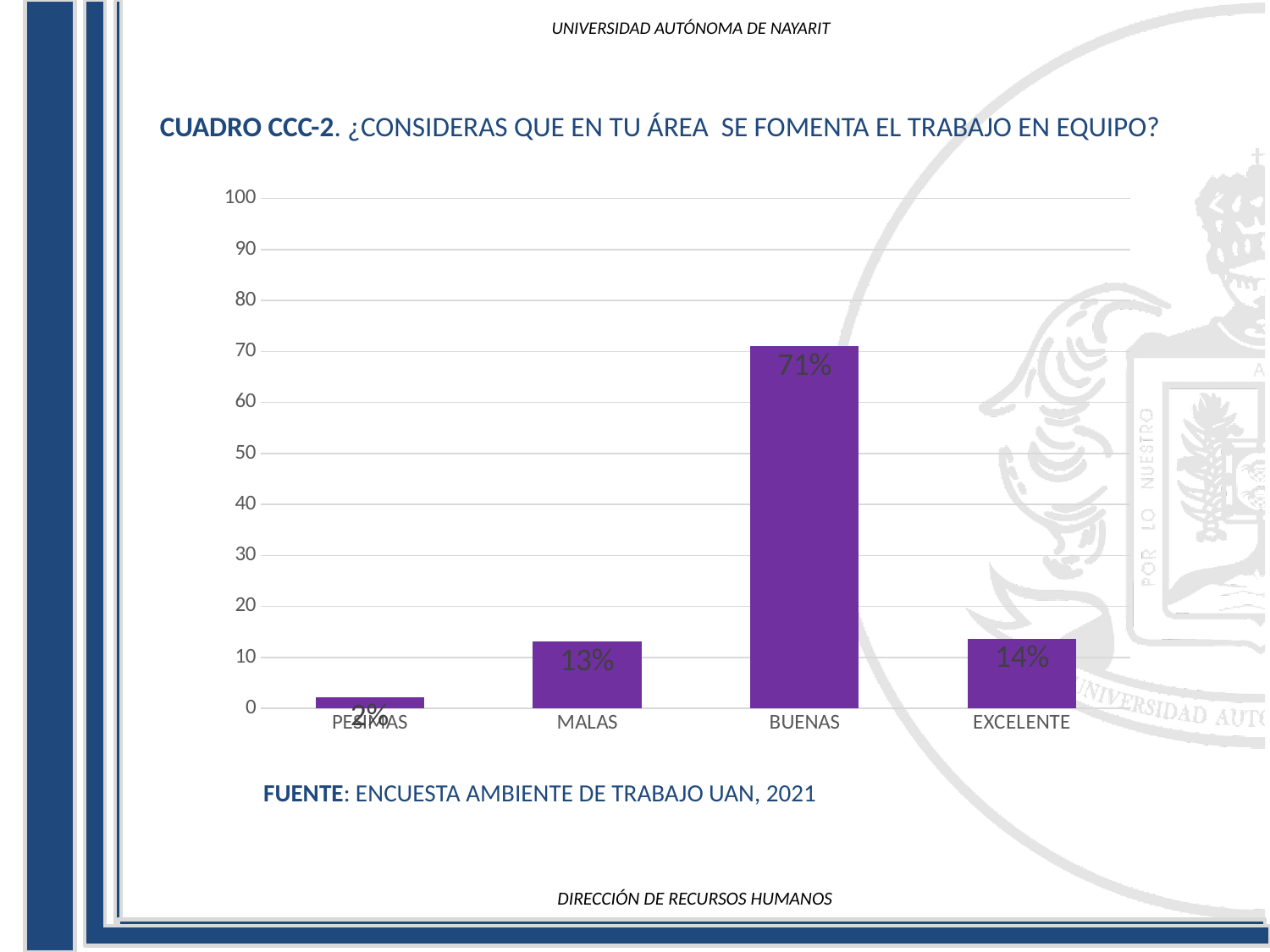
Which is larger, the value for MALAS or the value for EXCELENTE? EXCELENTE How many categories are shown on the x axis? 4 What is the value for EXCELENTE? 14% What is the value for BUENAS? 71% Which category has the highest value? BUENAS What is the difference between the values for BUENAS and EXCELENTE? 57% What source is cited below the chart? ENCUESTA AMBIENTE DE TRABAJO UAN, 2021 Is the value for BUENAS greater or less than 50? greater What kind of chart is shown on the slide? bar chart Which category has the lowest value? PESIMAS What is the value for MALAS? 13% What is the value for PESIMAS? 2%